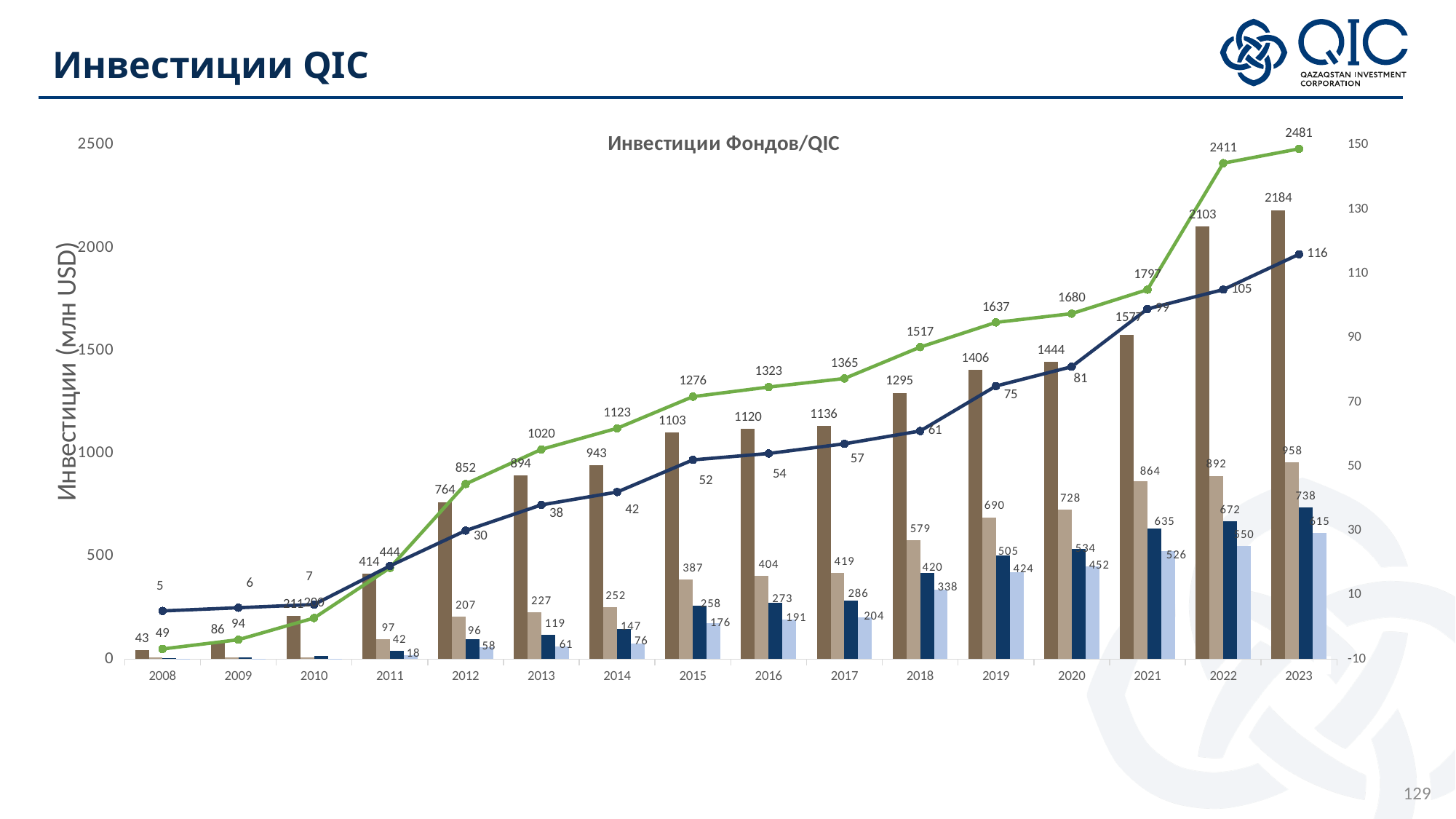
In which year is the dark brown bar highest? 2023 What is the value of the dark blue bar for 2021? 635 Does the green line rise or fall from 2008 to 2023? Rises What kind of chart is shown on the slide? Combined bar and line chart What is the title of the chart? Инвестиции Фондов/QIC How many years are shown along the x axis? 16 What is the difference between the green line values for 2023 and 2022? 70 What is the value of the dark brown bar for 2023? 2184 What is the value of the tan (light brown) bar for 2019? 690 In which year is the dark brown bar lowest? 2008 Which is larger in 2023: the dark blue bar or the light blue bar? The dark blue bar What is the value of the green line for 2023? 2481